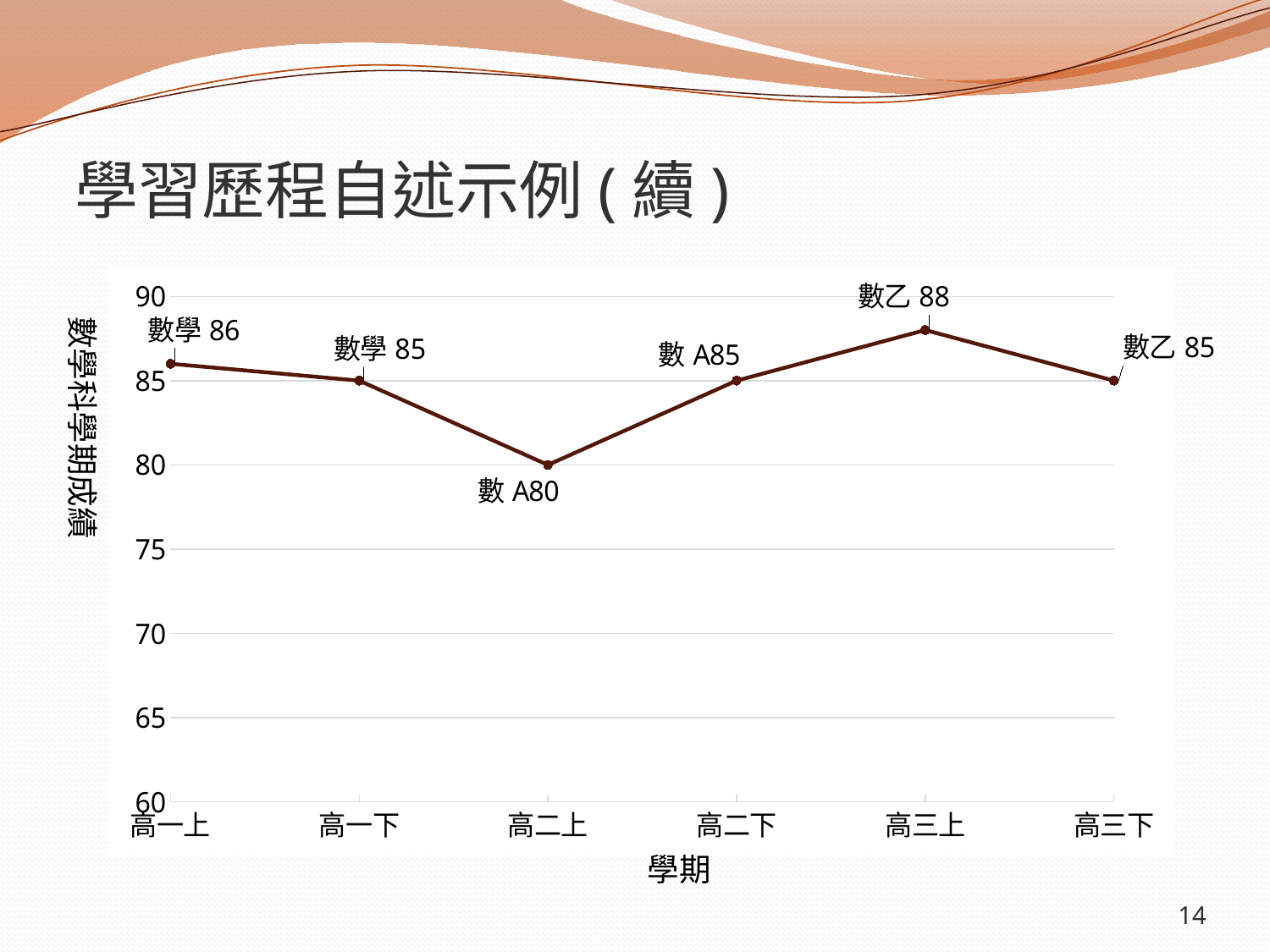
What is the value for 高三上? 88 Which is larger, the value for 高一上 or the value for 高一下? 高一上 How many semesters are plotted on the x axis? 6 Which semester has the lowest value? 高二上 What is the value for 高一上? 86 What is the value for 高三下? 85 Which semester has the highest value? 高三上 What kind of chart is shown? line chart What is the label of the x axis? 學期 What is the difference between the values for 高三上 and 高二上? 8 What is the value for 高二上? 80 Is the value for 高二上 greater or less than 85? less